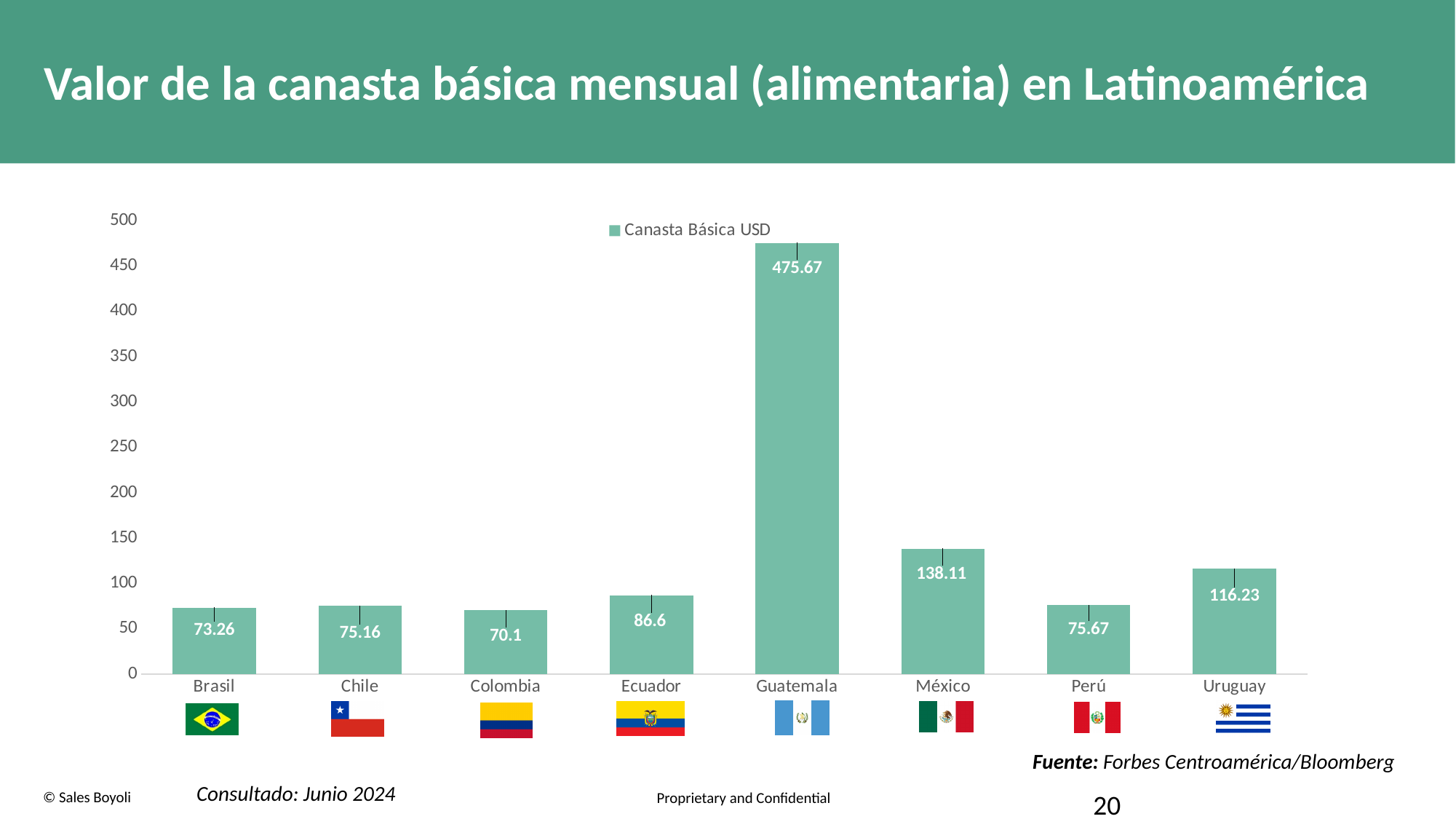
What is the difference between the values for Uruguay and Ecuador? 29.63 What kind of chart is shown on the slide? Bar chart How many countries are shown on the chart? 8 Which country has the lowest value? Colombia Which country has the highest value? Guatemala What is the series name shown in the legend? Canasta Básica USD Which is larger, the value for Ecuador or the value for Perú? Ecuador What is the value for Guatemala? 475.67 What is the difference between the values for Guatemala and México? 337.56 What is the value for México? 138.11 What is the value for Colombia? 70.1 What is the value for Uruguay? 116.23